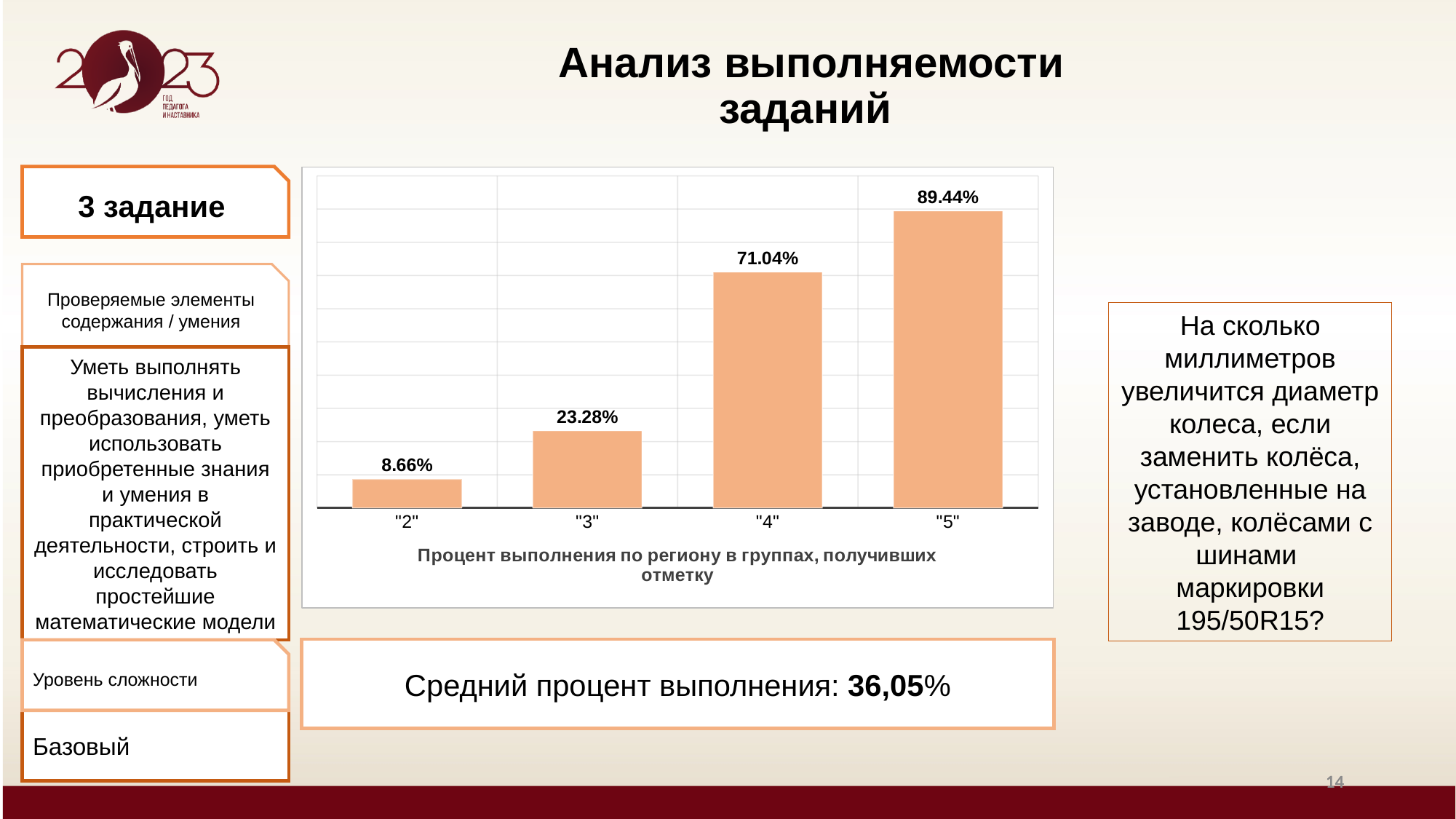
What kind of chart is shown on the slide? Bar chart What is the value for the group with mark "4"? 71.04% Which group has the lowest completion percentage? "2" How many groups (bars) are shown in the chart? 4 What is the value for the group with mark "5"? 89.44% What is the value for the group with mark "3"? 23.28% Which is larger, the value for group "3" or the value for group "4"? "4" What is the difference between the values for groups "5" and "4"? 18.40% Which group has the highest completion percentage? "5" Do the values rise or fall from group "2" to group "5"? Rise What is the value for the group with mark "2"? 8.66% What is the difference between the values for groups "3" and "2"? 14.62%